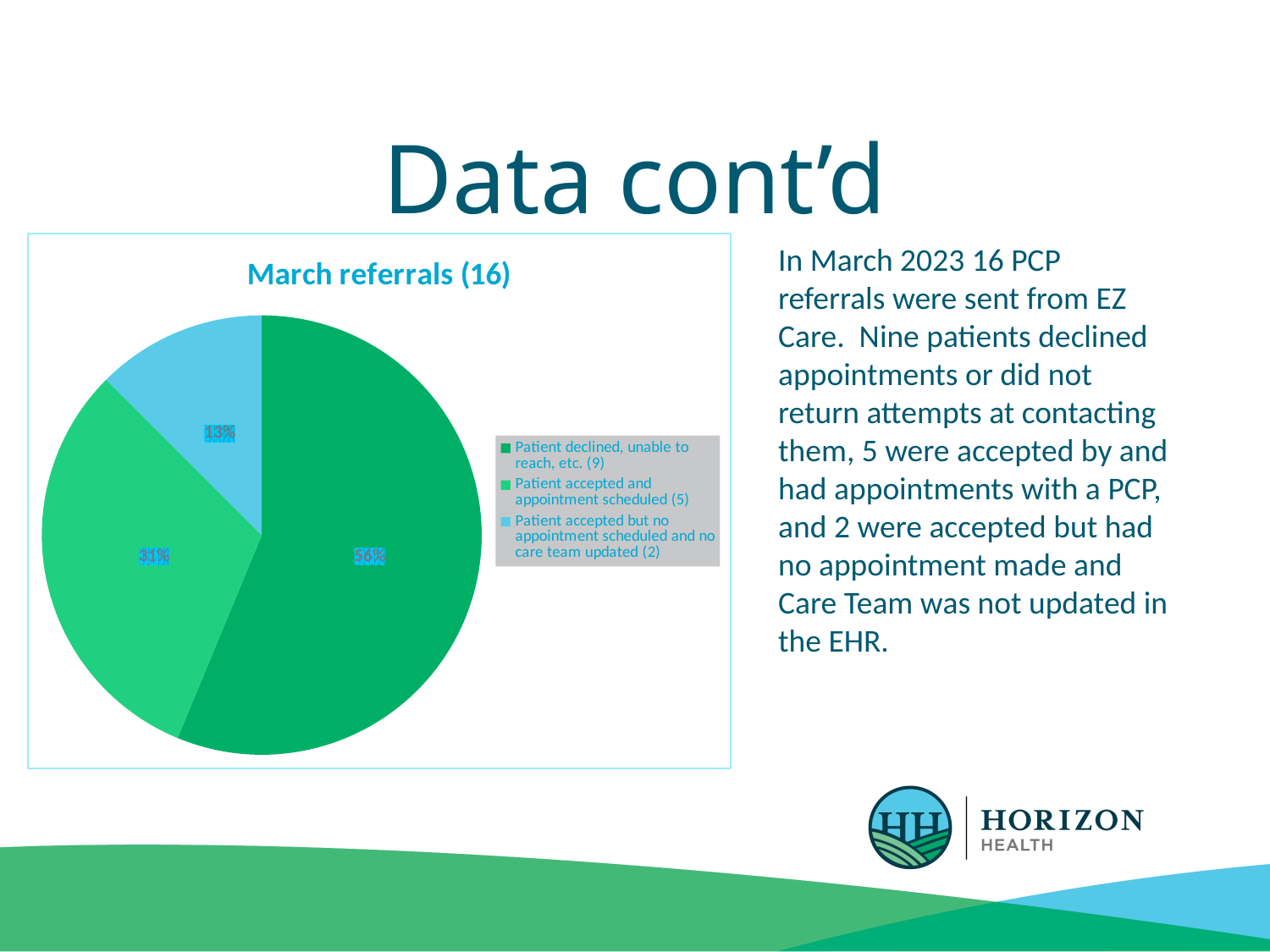
What is the difference in percentage points between the 'Patient declined, unable to reach, etc.' slice and the 'Patient accepted and appointment scheduled' slice? 25 percentage points Which category has the smallest slice of the pie? Patient accepted but no appointment scheduled and no care team updated (2) How many entries does the legend list? 3 What type of chart is shown on the slide? pie chart What share of the pie is labelled for 'Patient accepted but no appointment scheduled and no care team updated (2)'? 13% How many slices does the pie chart have? 3 Which category has the largest slice of the pie? Patient declined, unable to reach, etc. (9) What colour is the slice for 'Patient accepted but no appointment scheduled and no care team updated (2)'? light blue What share of the pie is labelled for 'Patient declined, unable to reach, etc. (9)'? 56% What is the title of the chart? March referrals (16) What share of the pie is labelled for 'Patient accepted and appointment scheduled (5)'? 31% Which slice is larger: 'Patient accepted and appointment scheduled' or 'Patient accepted but no appointment scheduled and no care team updated'? Patient accepted and appointment scheduled